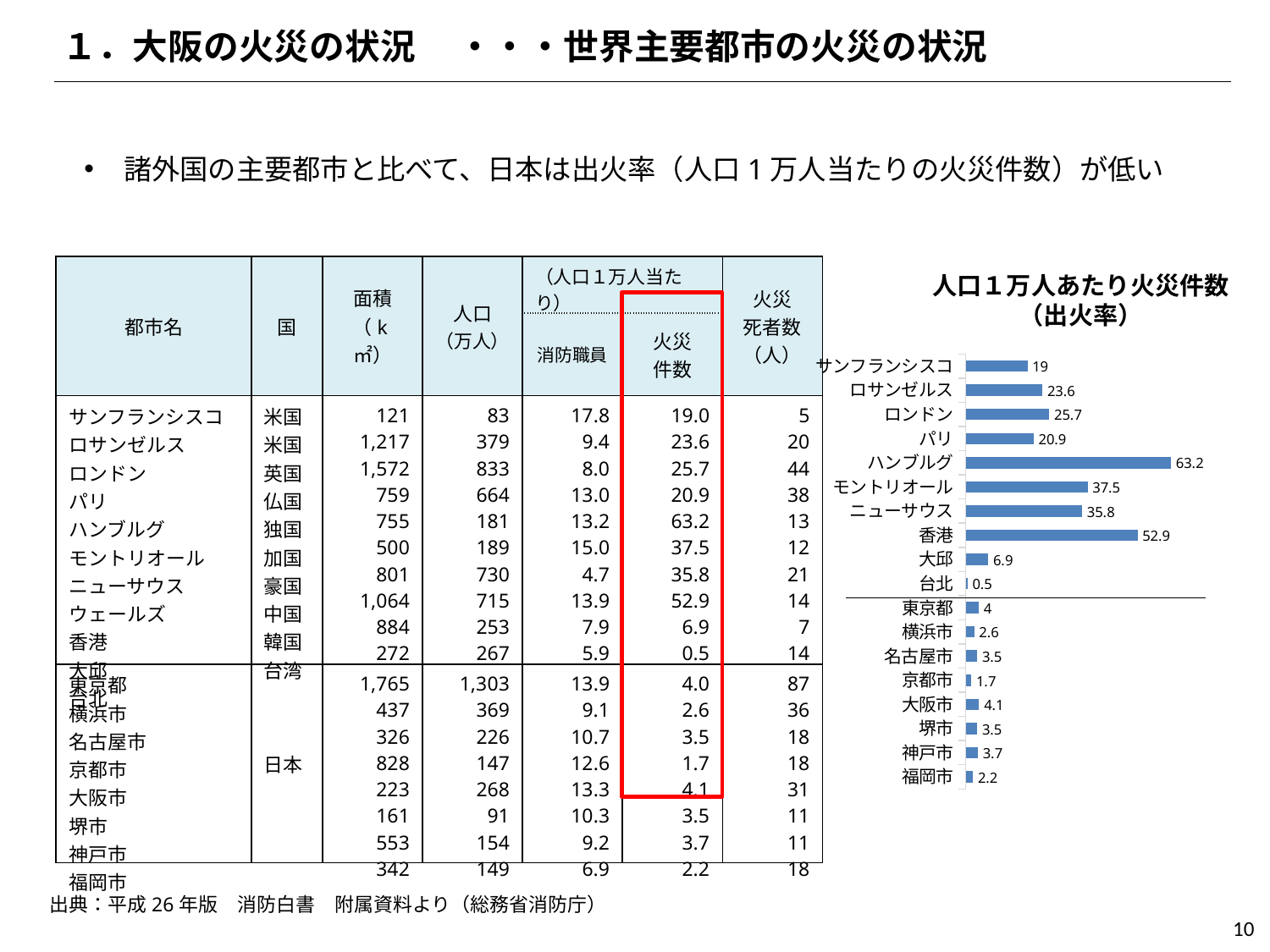
Which city has the lowest value in the chart? 台北 What is the difference between the values for 香港 and 東京都? 48.9 What is the value for モントリオール in the chart? 37.5 What is the value for 台北 in the chart? 0.5 Which city has the highest value in the chart? ハンブルグ What is the value for ハンブルグ in the chart? 63.2 Which has a larger value, ロンドン or ロサンゼルス? ロンドン What is the difference between the values for ニューサウス and パリ? 14.9 What type of chart is shown on the slide? bar chart What is the value for 大阪市 in the chart? 4.1 How many cities are plotted in the chart? 18 What is the title of the chart? 人口1万人あたり火災件数（出火率）